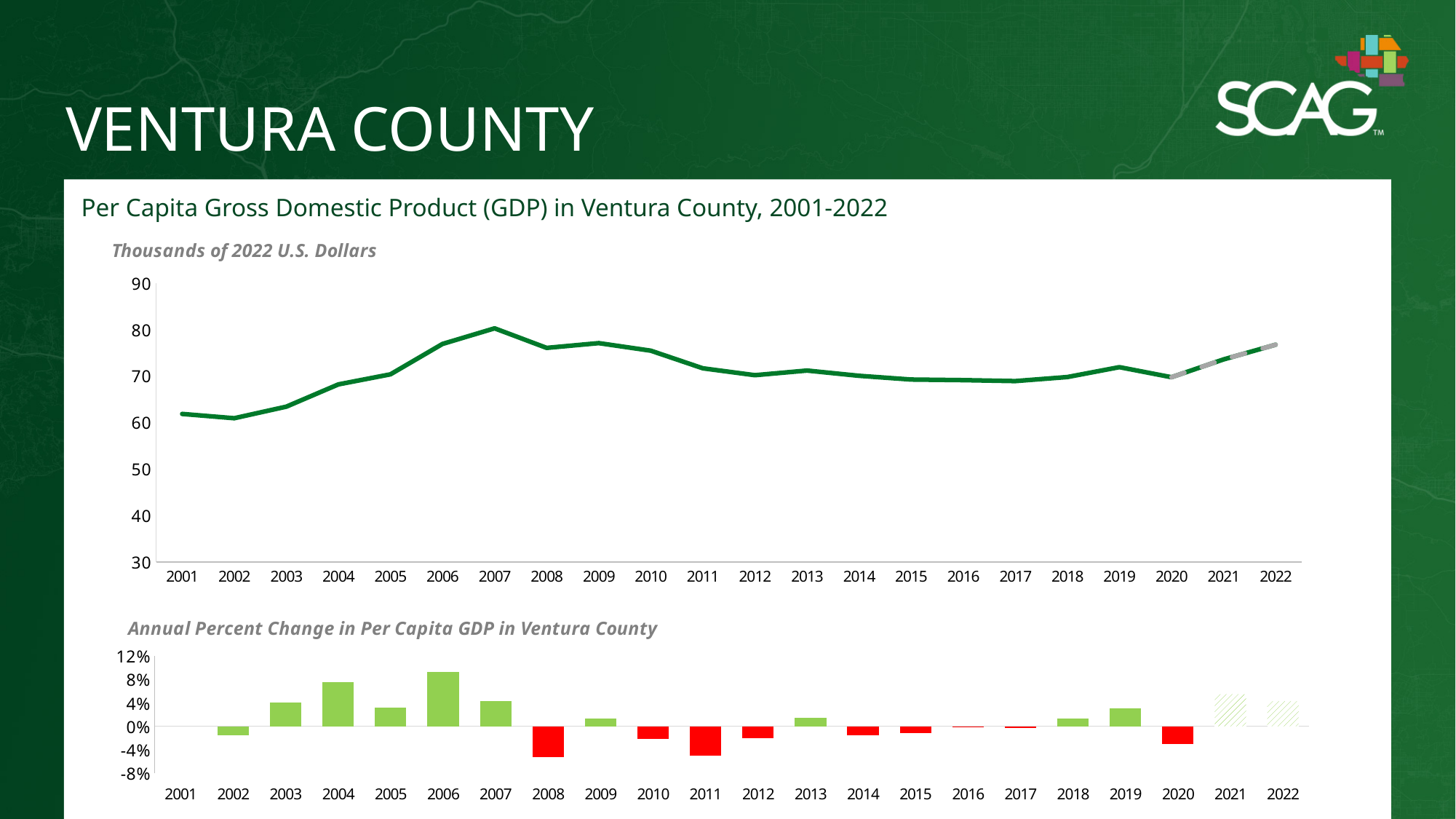
In the top line chart of per capita GDP, do the values rise or fall from 2002 to 2007? rise How many years are plotted on the x axis of the top line chart of per capita GDP? 22 In the top line chart of per capita GDP, is the value for 2007 greater or less than 70? greater In the top line chart of per capita GDP, is the value for 2001 greater or less than 70? less In the top line chart of per capita GDP, which is larger, the value for 2007 or the value for 2012? 2007 In the bottom bar chart of annual percent change, is the value for 2006 greater or less than 8%? greater In the top line chart of per capita GDP, which year has the highest value? 2007 In the bottom bar chart of annual percent change, which is larger, the value for 2004 or the value for 2005? 2004 What kind of chart is the bottom chart, 'Annual Percent Change in Per Capita GDP in Ventura County'? bar chart In the bottom bar chart of annual percent change, which year has the highest value? 2006 What kind of chart is the top chart, 'Per Capita Gross Domestic Product (GDP) in Ventura County, 2001-2022'? line chart